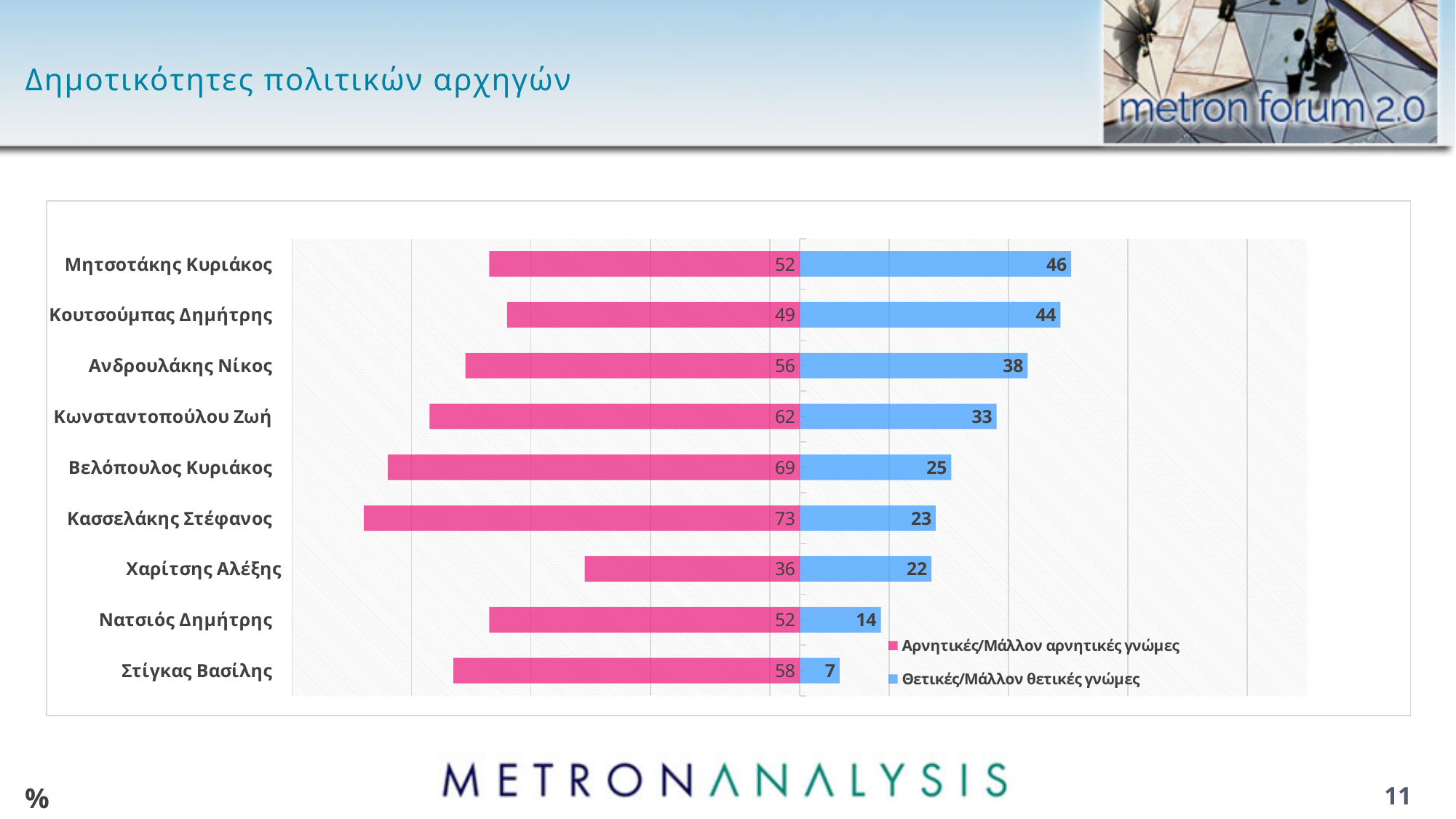
What is the total of the two values shown for Κουτσούμπας Δημήτρης? 93 What is the value of Αρνητικές/Μάλλον αρνητικές γνώμες for Κασσελάκης Στέφανος? 73 How many politicians are shown in the chart? 9 What is the difference between the Αρνητικές/Μάλλον αρνητικές γνώμες value and the Θετικές/Μάλλον θετικές γνώμες value for Βελόπουλος Κυριάκος? 44 Which is larger: the Θετικές/Μάλλον θετικές γνώμες value for Ανδρουλάκης Νίκος or for Κωνσταντοπούλου Ζωή? Ανδρουλάκης Νίκος Which colour represents Αρνητικές/Μάλλον αρνητικές γνώμες in the chart? Pink What kind of chart is shown on the slide? Bar chart How many series does the legend list? 2 Which politician has the lowest value for Αρνητικές/Μάλλον αρνητικές γνώμες? Χαρίτσης Αλέξης What is the value of Θετικές/Μάλλον θετικές γνώμες for Στίγκας Βασίλης? 7 Which politician has the highest value for Θετικές/Μάλλον θετικές γνώμες? Μητσοτάκης Κυριάκος What is the value of Θετικές/Μάλλον θετικές γνώμες for Μητσοτάκης Κυριάκος? 46